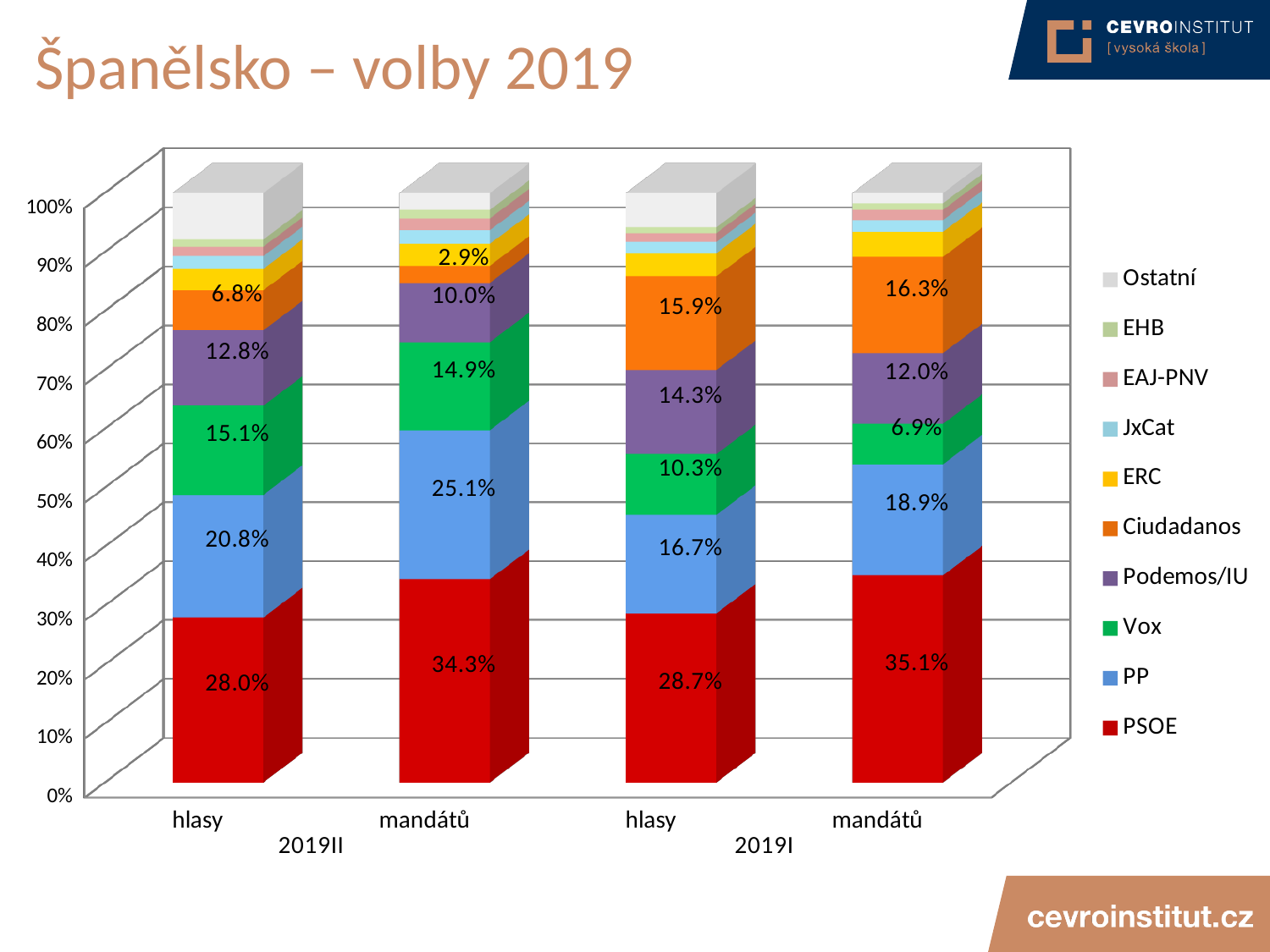
How many series does the legend list? 10 What is the Ciudadanos share in the 'hlasy' bar for 2019I? 15.9% In which bar is the PSOE share the highest? mandátů 2019I What is the difference between the PSOE share in 'mandátů' 2019II and in 'hlasy' 2019II? 6.3% What is the PSOE share in the 'hlasy' bar for 2019II? 28.0% What is the Podemos/IU share in the 'hlasy' bar for 2019II? 12.8% Which is larger: the Vox share in 'hlasy' 2019II or the Vox share in 'hlasy' 2019I? hlasy 2019II How many bars are plotted in the chart? 4 What is the chart's title? Španělsko – volby 2019 What kind of chart is shown on the slide? stacked bar chart What is the PP share in the 'mandátů' bar for 2019II? 25.1% What is the Vox share in the 'mandátů' bar for 2019I? 6.9%